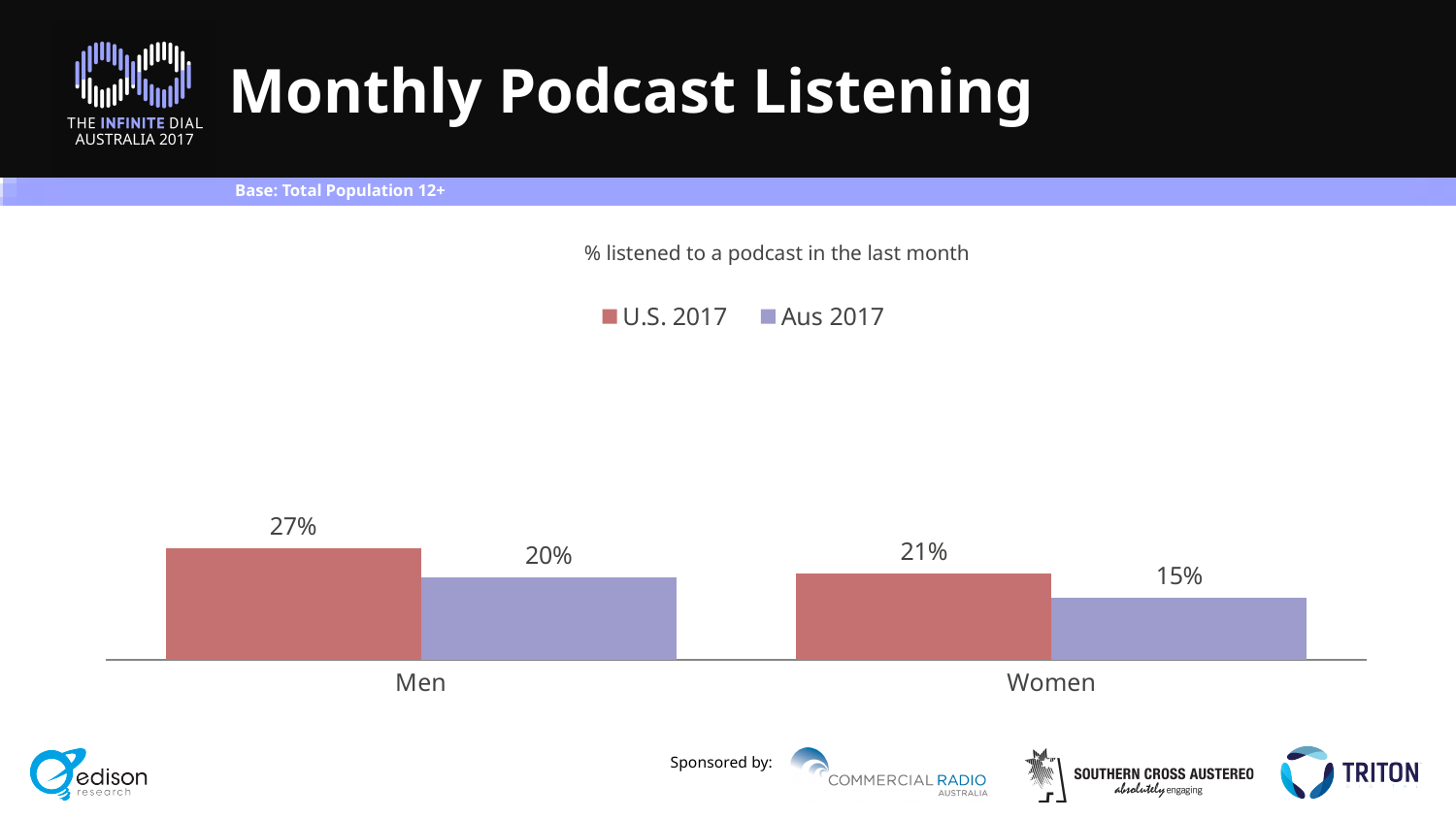
Which is larger: the Aus 2017 value for Men or the U.S. 2017 value for Women? U.S. 2017 value for Women What kind of chart is shown on the slide? Bar chart What is the value for Men in the Aus 2017 series? 20% What is the difference between the U.S. 2017 and Aus 2017 values for Women? 6 percentage points What is the value for Women in the U.S. 2017 series? 21% What is the value for Women in the Aus 2017 series? 15% How many series does the legend list? 2 Which group and series has the highest monthly podcast listening value? Men, U.S. 2017 What is the difference between the U.S. 2017 and Aus 2017 values for Men? 7 percentage points Which group and series has the lowest monthly podcast listening value? Women, Aus 2017 What percentage of men in the U.S. 2017 listened to a podcast in the last month? 27% How many categories are shown on the x axis? 2